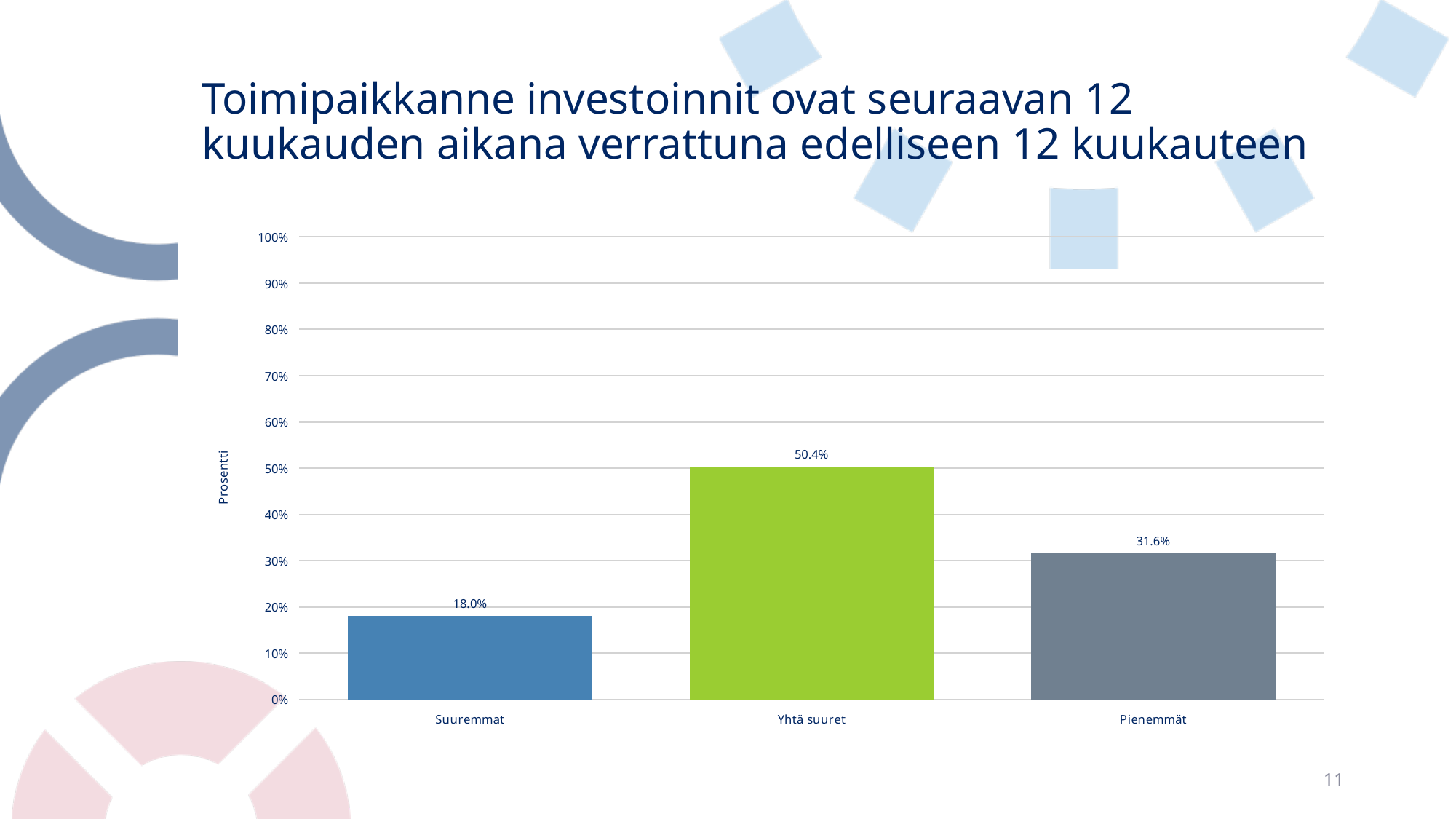
What is the difference between the values for Yhtä suuret and Pienemmät? 18.8% What is the label of the vertical axis? Prosentti What is the value for Pienemmät? 31.6% Which is larger, the value for Pienemmät or the value for Suuremmat? Pienemmät What kind of chart is shown on the slide? bar chart Which category has the lowest value? Suuremmat Which category has the highest value? Yhtä suuret What is the value for Suuremmat? 18.0% Is the value for Yhtä suuret greater or less than 50%? greater How many categories are shown on the x axis? 3 What is the difference between the values for Pienemmät and Suuremmat? 13.6% What is the value for Yhtä suuret? 50.4%